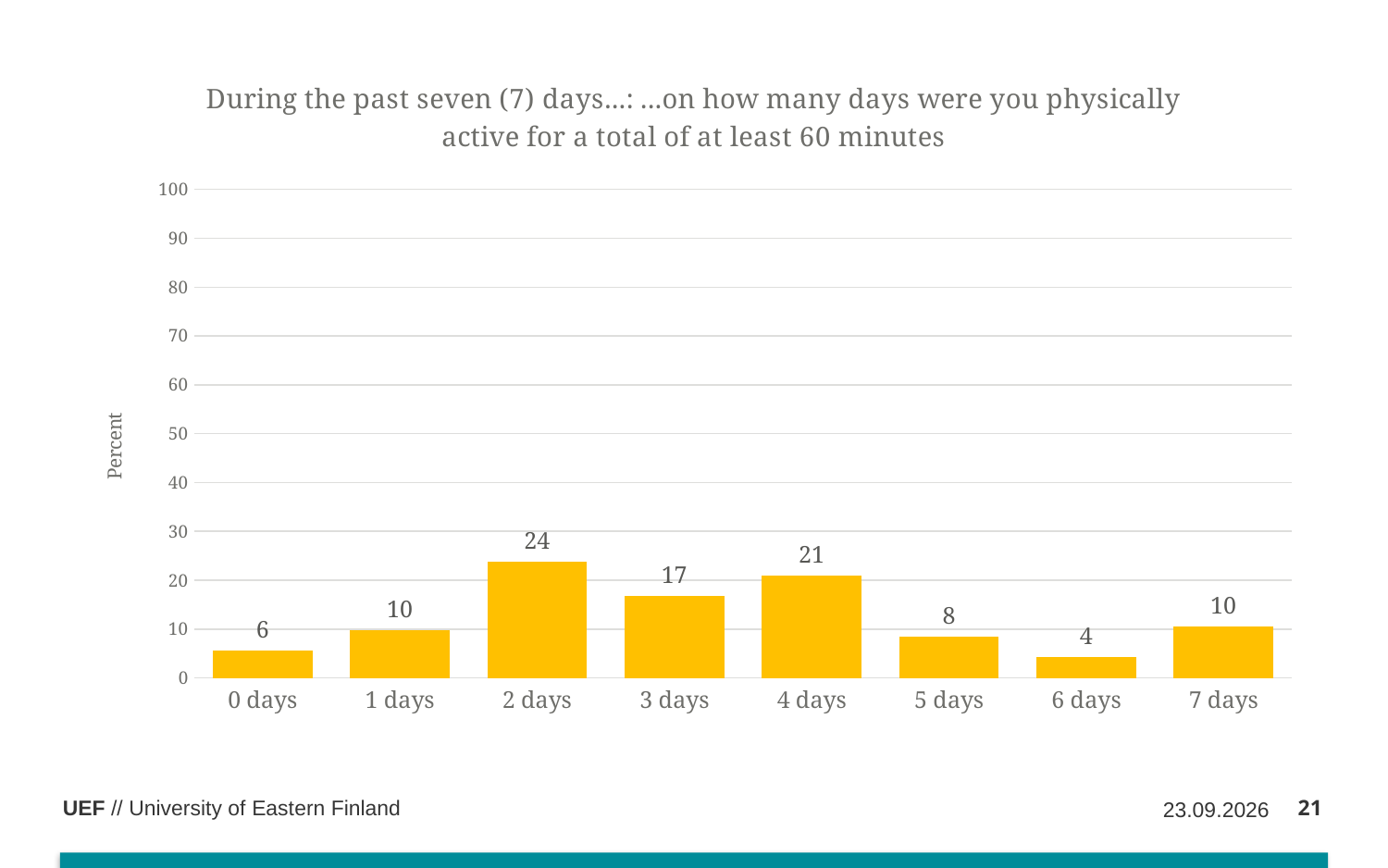
What is the label of the y axis? Percent What kind of chart is this? bar chart Which category has the highest value? 2 days How many categories are shown on the x axis? 8 What is the difference between the values for 2 days and 3 days? 7 What is the value for 2 days? 24 What is the value for 6 days? 4 Which category has the lowest value? 6 days Is the value for 4 days greater or less than 20? greater What is the value for 4 days? 21 Which is larger, the value for 0 days or the value for 5 days? 5 days What is the difference between the values for 1 days and 7 days? 0